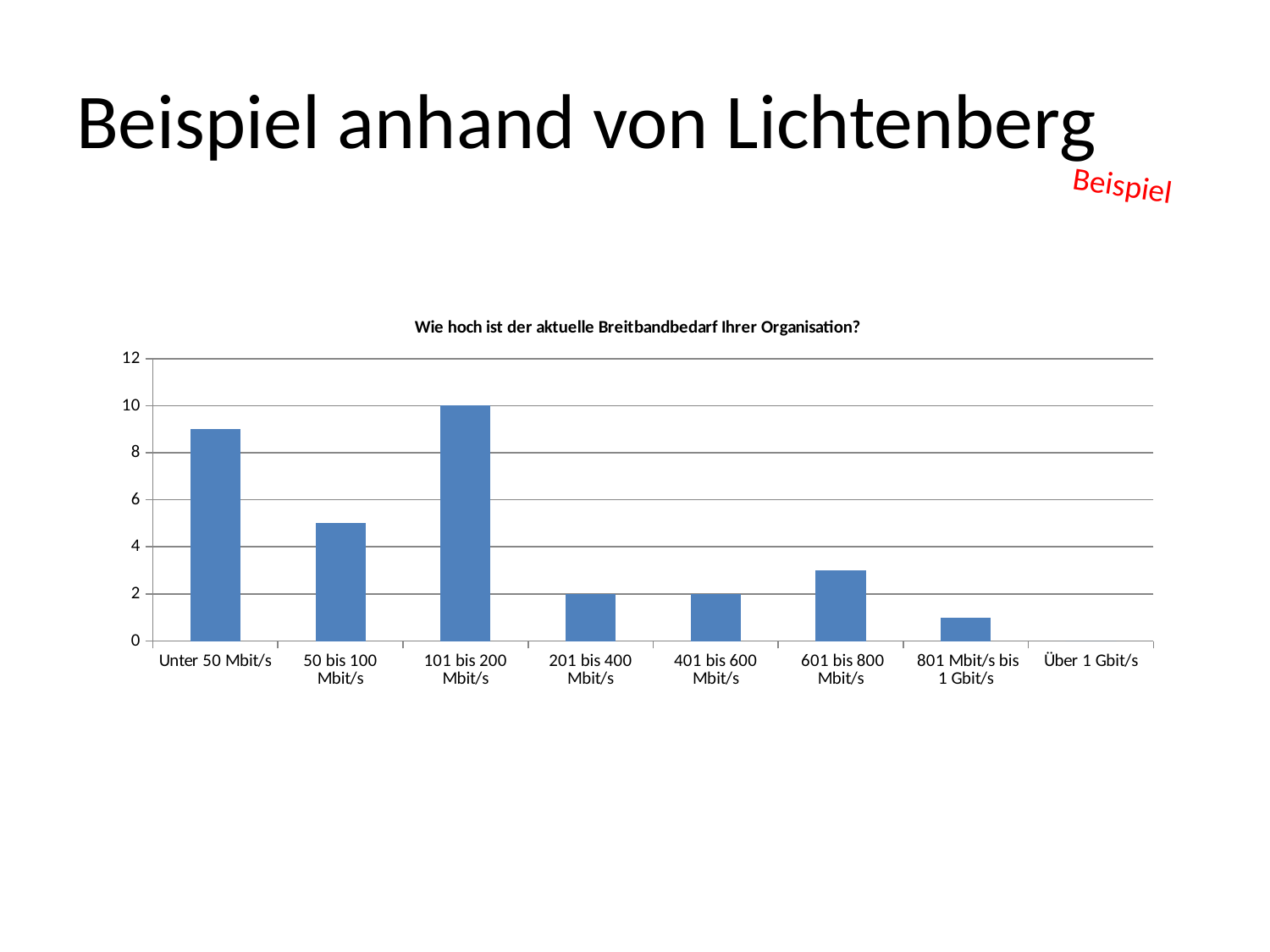
Which category has the lowest value? Über 1 Gbit/s What type of chart is shown on the slide? bar chart Which is larger, the value for "Unter 50 Mbit/s" or the value for "50 bis 100 Mbit/s"? Unter 50 Mbit/s What is the value for the category "Über 1 Gbit/s"? 0 What is the value for the category "101 bis 200 Mbit/s"? 10 What is the value for the category "201 bis 400 Mbit/s"? 2 What is the title of the chart? Wie hoch ist der aktuelle Breitbandbedarf Ihrer Organisation? How many categories are shown on the x axis of the chart? 8 Which category has the highest value? 101 bis 200 Mbit/s What is the value for the category "401 bis 600 Mbit/s"? 2 Is the value for "Unter 50 Mbit/s" greater or less than 8? greater What is the difference between the values for "101 bis 200 Mbit/s" and "201 bis 400 Mbit/s"? 8